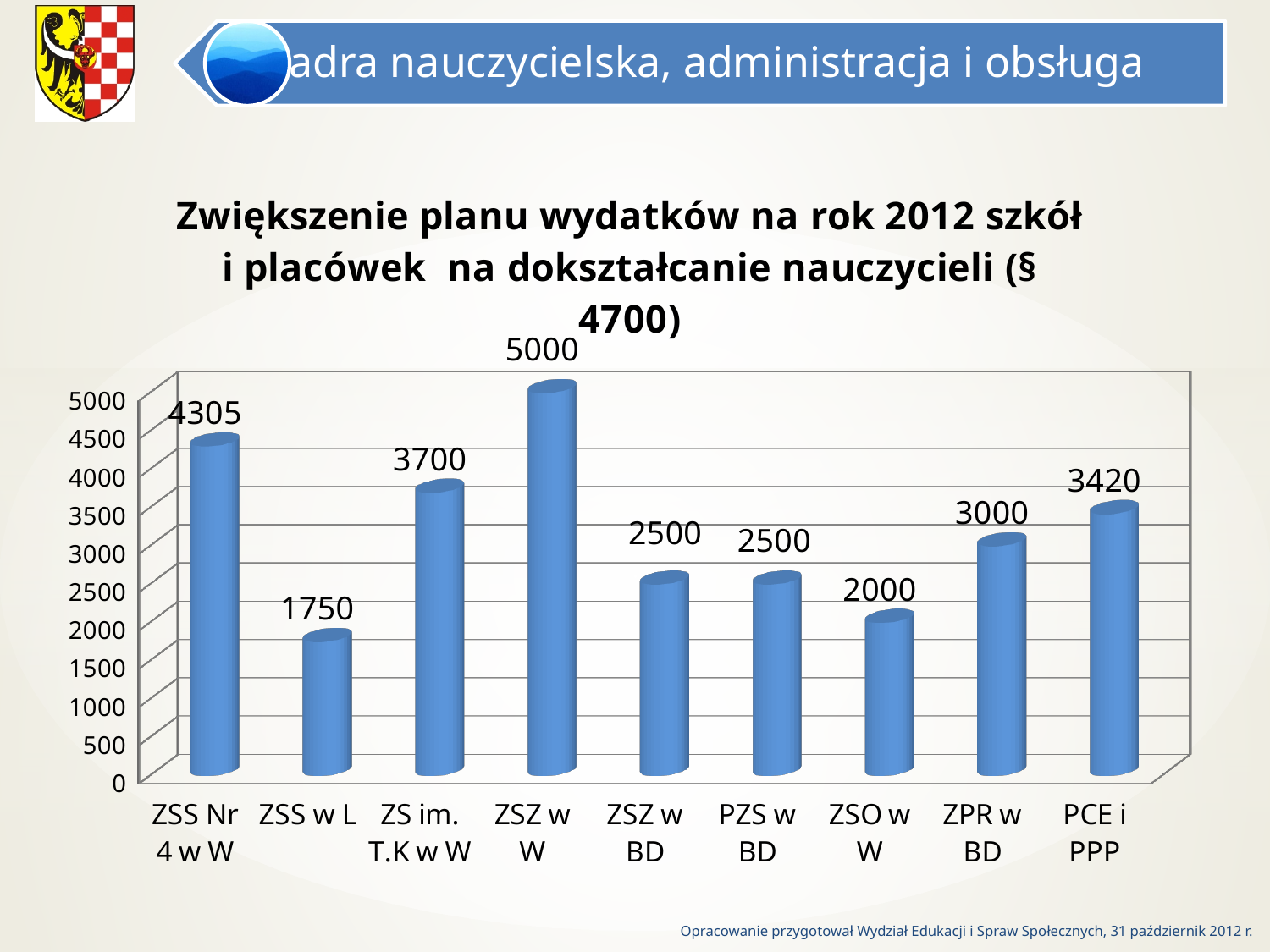
Which category has the highest value? ZSZ w W Is the value for ZSO w W greater or less than 2500? less What is the value for PCE i PPP? 3420 What is the title of the chart? Zwiększenie planu wydatków na rok 2012 szkół i placówek na dokształcanie nauczycieli (§ 4700) What is the difference between the values for ZPR w BD and ZSO w W? 1000 What is the value for ZSS Nr 4 w W? 4305 What is the value for ZSS w L? 1750 Which is larger, the value for ZS im. T.K w W or the value for ZPR w BD? ZS im. T.K w W What kind of chart is this? bar chart What is the difference between the values for ZSZ w W and ZSS Nr 4 w W? 695 Which category has the lowest value? ZSS w L How many categories are shown on the x axis? 9